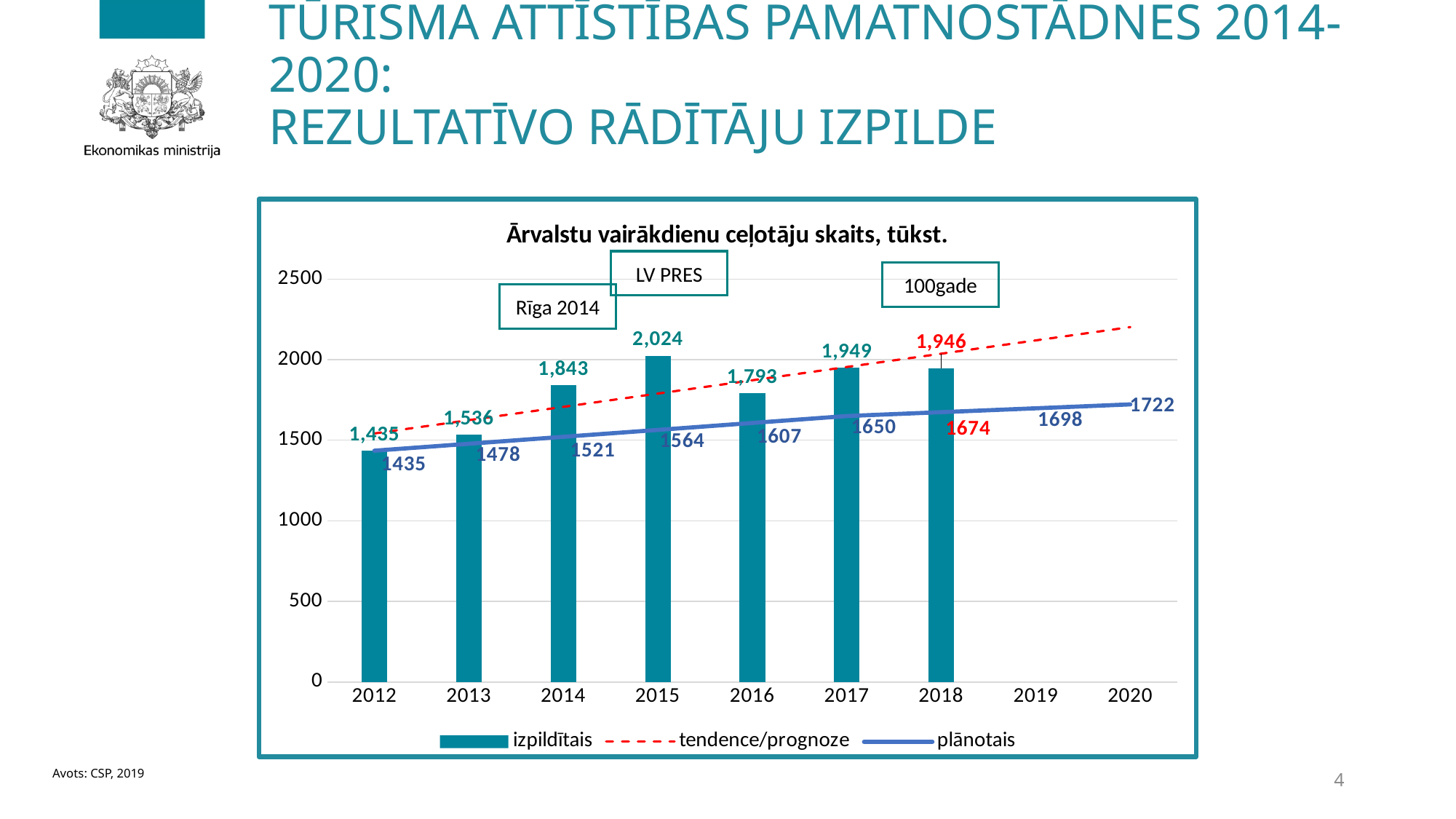
What is the plānotais value for 2020? 1722 Is the izpildītais value for 2016 greater or less than 2000? less How many years have an izpildītais bar? 7 In 2018, how much higher is the izpildītais value than the plānotais value? 272 How many series does the legend list? 3 Which is larger, the izpildītais value for 2016 or for 2017? 2017 Which year has the highest izpildītais bar? 2015 What kind of chart is shown? bar chart with line series What is the izpildītais value for 2015? 2,024 Which year has the lowest izpildītais bar? 2012 What is the difference between the izpildītais values for 2015 and 2014? 181 Does the plānotais line rise or fall from 2012 to 2020? rises